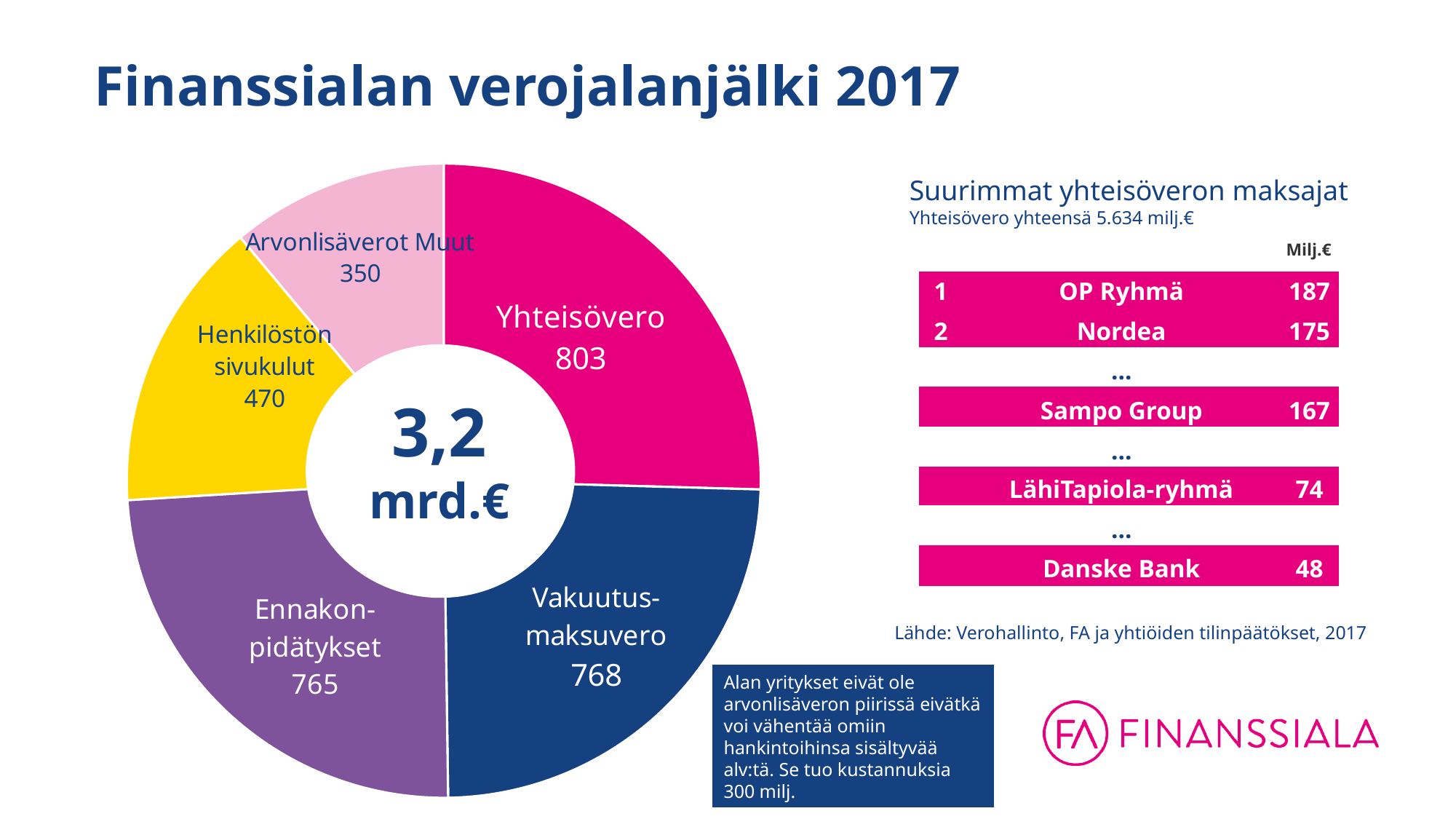
What kind of chart is shown on the left of the slide? Pie (doughnut) chart What is the value for Yhteisövero in the donut chart? 803 What is the difference between the values for Henkilöstön sivukulut and Arvonlisäverot Muut in the donut chart? 120 What total is printed in the centre of the donut chart? 3,2 mrd.€ What is the value for Ennakonpidätykset in the donut chart? 765 What is the value for Henkilöstön sivukulut in the donut chart? 470 Which segment of the donut chart has the lowest value? Arvonlisäverot Muut In the donut chart, which is larger: Henkilöstön sivukulut or Arvonlisäverot Muut? Henkilöstön sivukulut What is the value for Arvonlisäverot Muut in the donut chart? 350 What is the difference between the values for Yhteisövero and Arvonlisäverot Muut in the donut chart? 453 How many segments does the donut chart have? 5 Which segment of the donut chart has the highest value? Yhteisövero